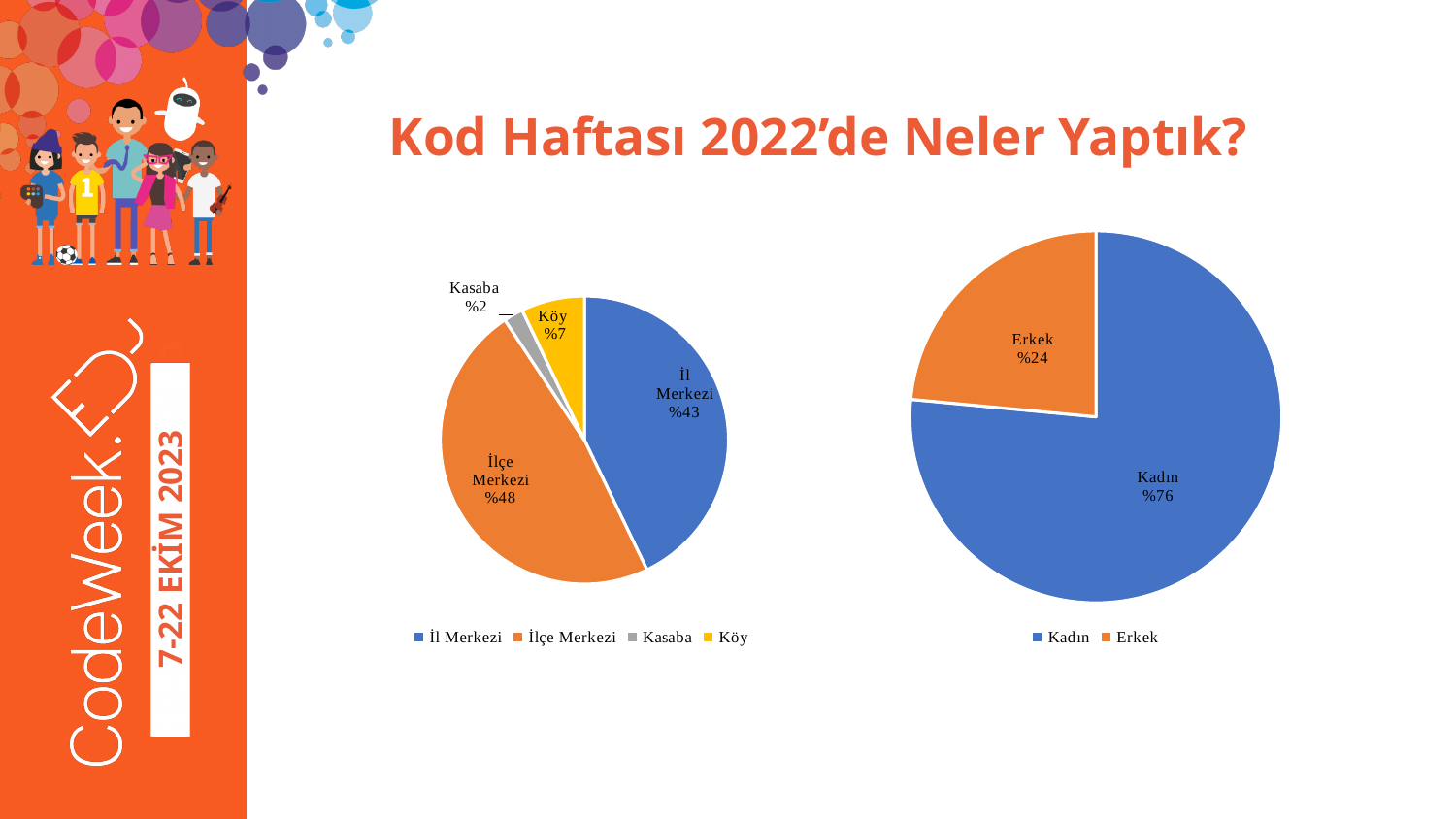
In the left pie chart, how many categories are shown? 4 What type of chart is the right chart? Pie chart In the right pie chart, what share does Erkek have? %24 In the left pie chart, which is larger, İl Merkezi or Köy? İl Merkezi In the left pie chart, what colour is the Köy slice? Yellow In the left pie chart, which category has the smallest share? Kasaba In the right pie chart, what is the difference in percentage points between Kadın and Erkek? 52 In the left pie chart, what share does Kasaba have? %2 In the left pie chart, what is the difference in percentage points between İl Merkezi and Köy? 36 In the right pie chart, what share does Kadın have? %76 In the left pie chart, what share does İlçe Merkezi have? %48 In the left pie chart, which category has the largest share? İlçe Merkezi